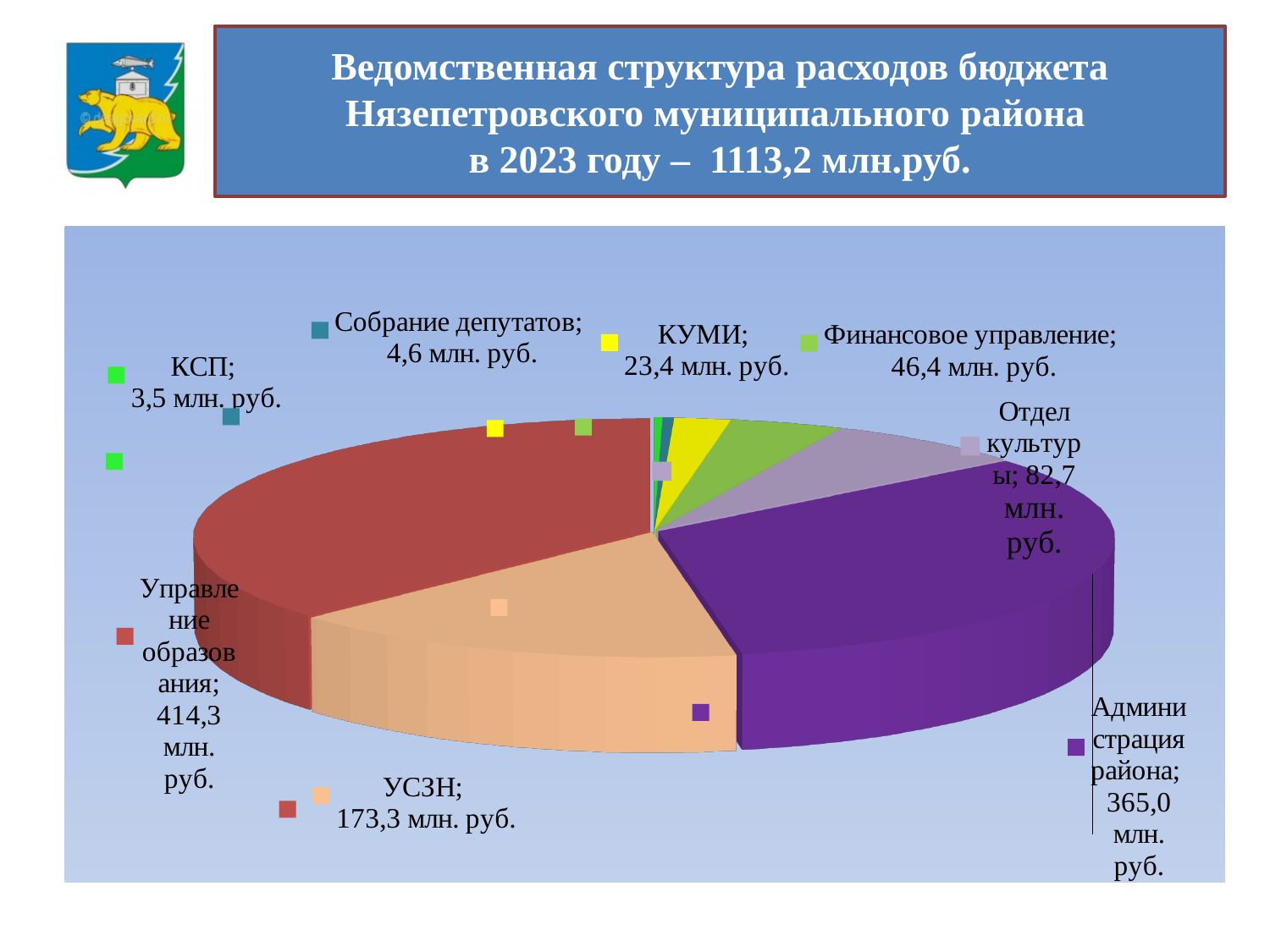
Which category has the smallest value? КСП What is the difference between Финансовое управление and КУМИ? 23,0 млн. руб. What colour is the slice for Администрация района? Purple What is the value for Управление образования? 414,3 млн. руб. Which is larger, УСЗН or Отдел культуры? УСЗН What kind of chart is shown on the slide? Pie chart What is the difference between Управление образования and Администрация района? 49,3 млн. руб. What is the value for Администрация района? 365,0 млн. руб. What is the value for УСЗН? 173,3 млн. руб. What is the value for Финансовое управление? 46,4 млн. руб. How many categories (slices) does the pie chart have? 8 Which category has the largest share of the pie? Управление образования